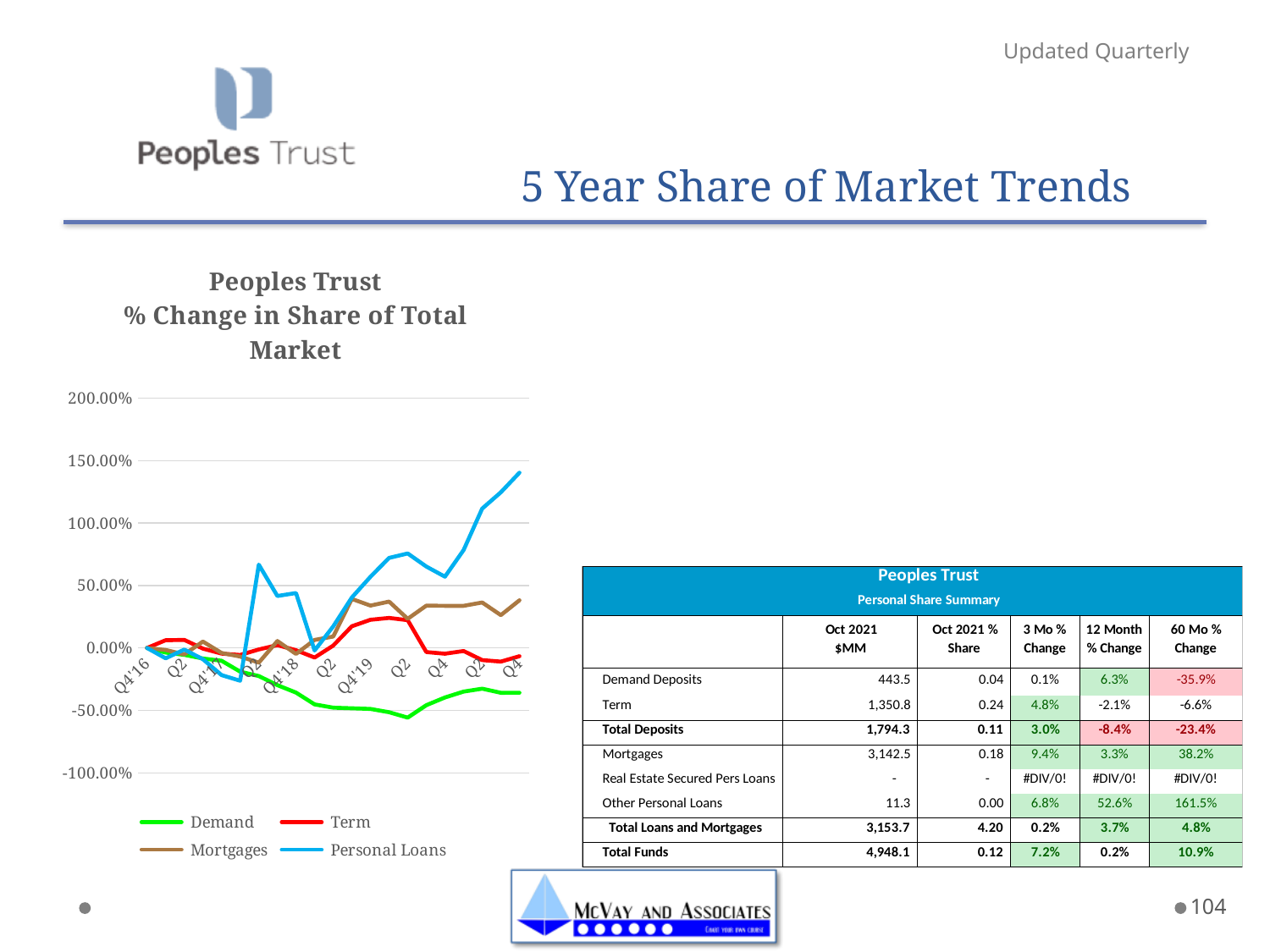
Which series has the lowest value at the final Q4 point on the chart? Demand At the final Q4 point, which is larger: the value for Mortgages or the value for Demand? Mortgages Does the Personal Loans line generally rise or fall from Q4'18 to the final Q4 point? rise Is the value for Mortgages at the final Q4 point greater or less than 50.00%? less Is the value for Personal Loans at the final Q4 point greater or less than 100.00%? greater Which series in the chart is drawn in blue? Personal Loans What kind of chart is shown on the slide? line chart Is the value for Demand at the final Q4 point greater or less than 0.00%? less What is the title of the chart? Peoples Trust % Change in Share of Total Market Which series has the highest value at the final Q4 point on the chart? Personal Loans How many series does the chart legend list? 4 How many category labels are shown along the x axis of the chart? 11